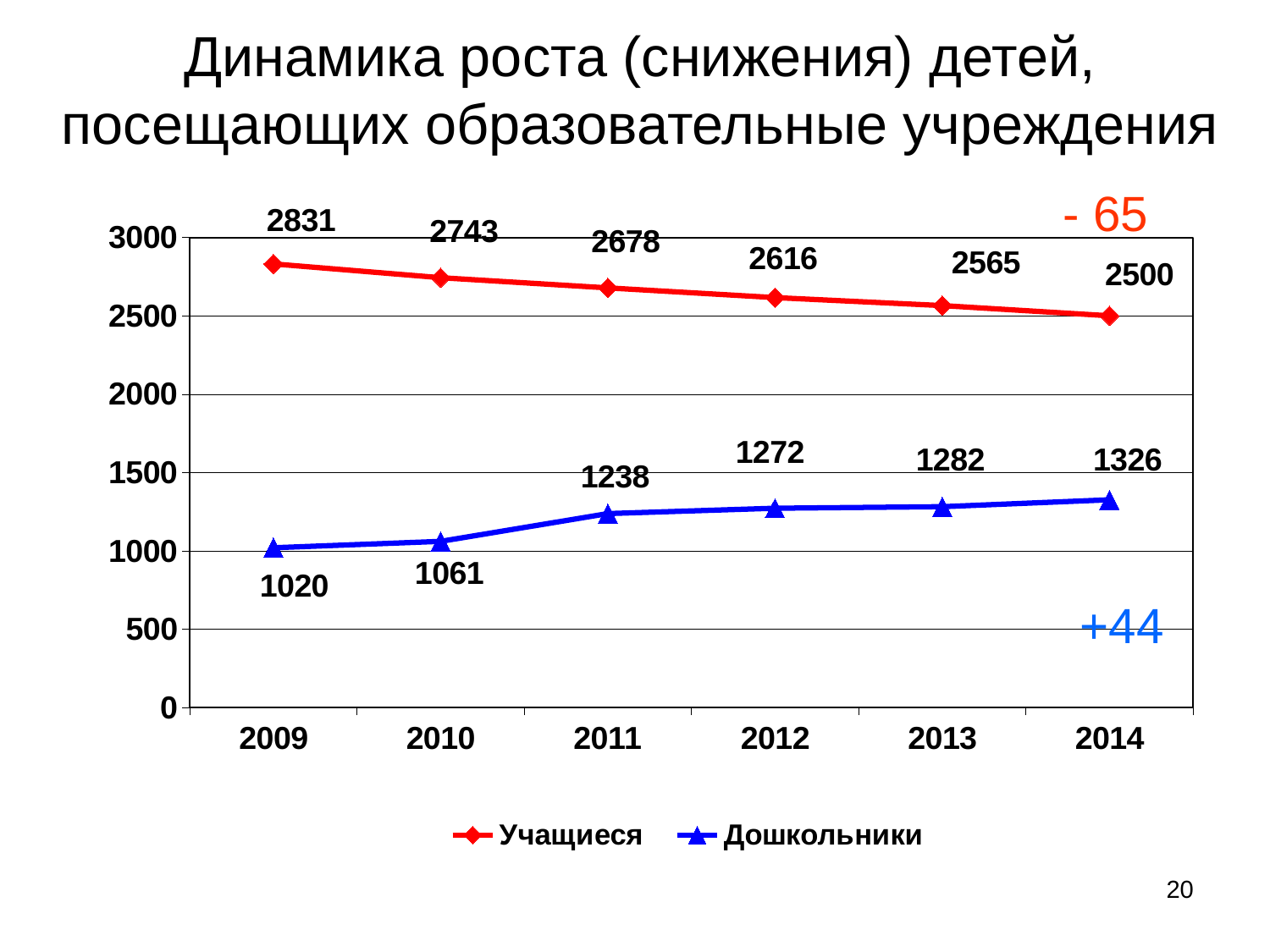
What is the value for Учащиеся in 2009? 2831 What is the difference between the Учащиеся values in 2013 and 2014? 65 What is the value for Дошкольники in 2014? 1326 What is the difference between the Дошкольники values in 2011 and 2010? 177 In which year is the value for Дошкольники lowest? 2009 What is the value for Учащиеся in 2012? 2616 How many series does the legend list? 2 Do the values for Учащиеся rise or fall from 2009 to 2014? fall How many years are shown on the x axis? 6 What kind of chart is shown on the slide? line chart In which year is the value for Учащиеся highest? 2009 Which is larger in 2011: the value for Учащиеся or the value for Дошкольники? Учащиеся